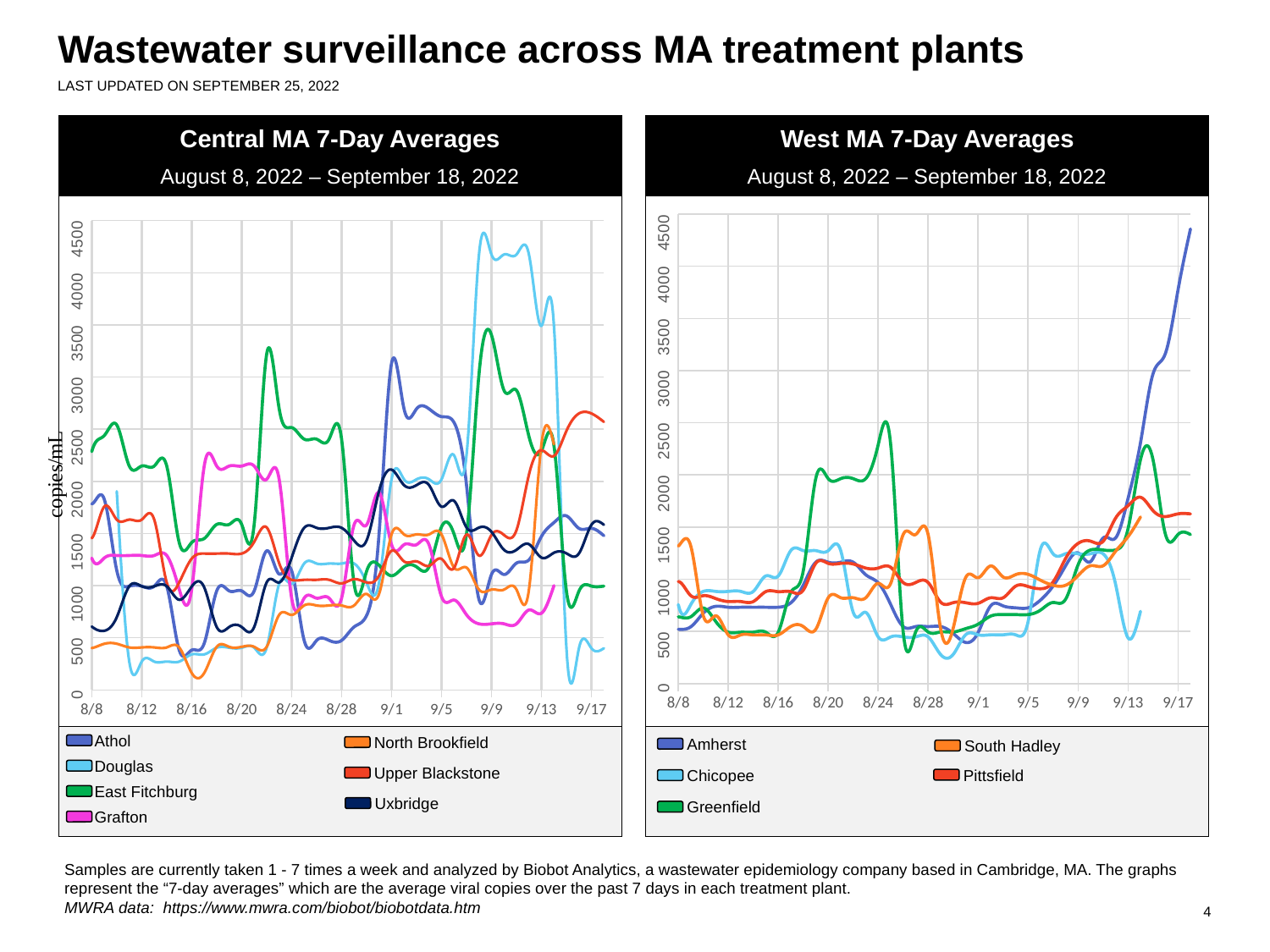
In the Central MA 7-Day Averages chart, which series reaches the highest value? Douglas What is the y-axis label on the Central MA 7-Day Averages chart? copies/mL In the West MA 7-Day Averages chart, is the peak value for Greenfield greater or less than 2000? greater In the West MA 7-Day Averages chart, which series reaches the highest value? Amherst What date range is shown in the subtitle of the West MA 7-Day Averages chart? August 8, 2022 – September 18, 2022 In the Central MA 7-Day Averages chart, at 9/17, which is larger: Upper Blackstone or Douglas? Upper Blackstone In the Central MA 7-Day Averages chart, is the peak value for Douglas greater or less than 4000? greater How many series does the legend of the West MA 7-Day Averages chart list? 5 How many series does the legend of the Central MA 7-Day Averages chart list? 7 In the West MA 7-Day Averages chart, is the peak value for Amherst greater or less than 4000? greater What type of chart is the Central MA 7-Day Averages chart? line chart In the West MA 7-Day Averages chart, does the Amherst line rise or fall between 9/9 and 9/17? rise